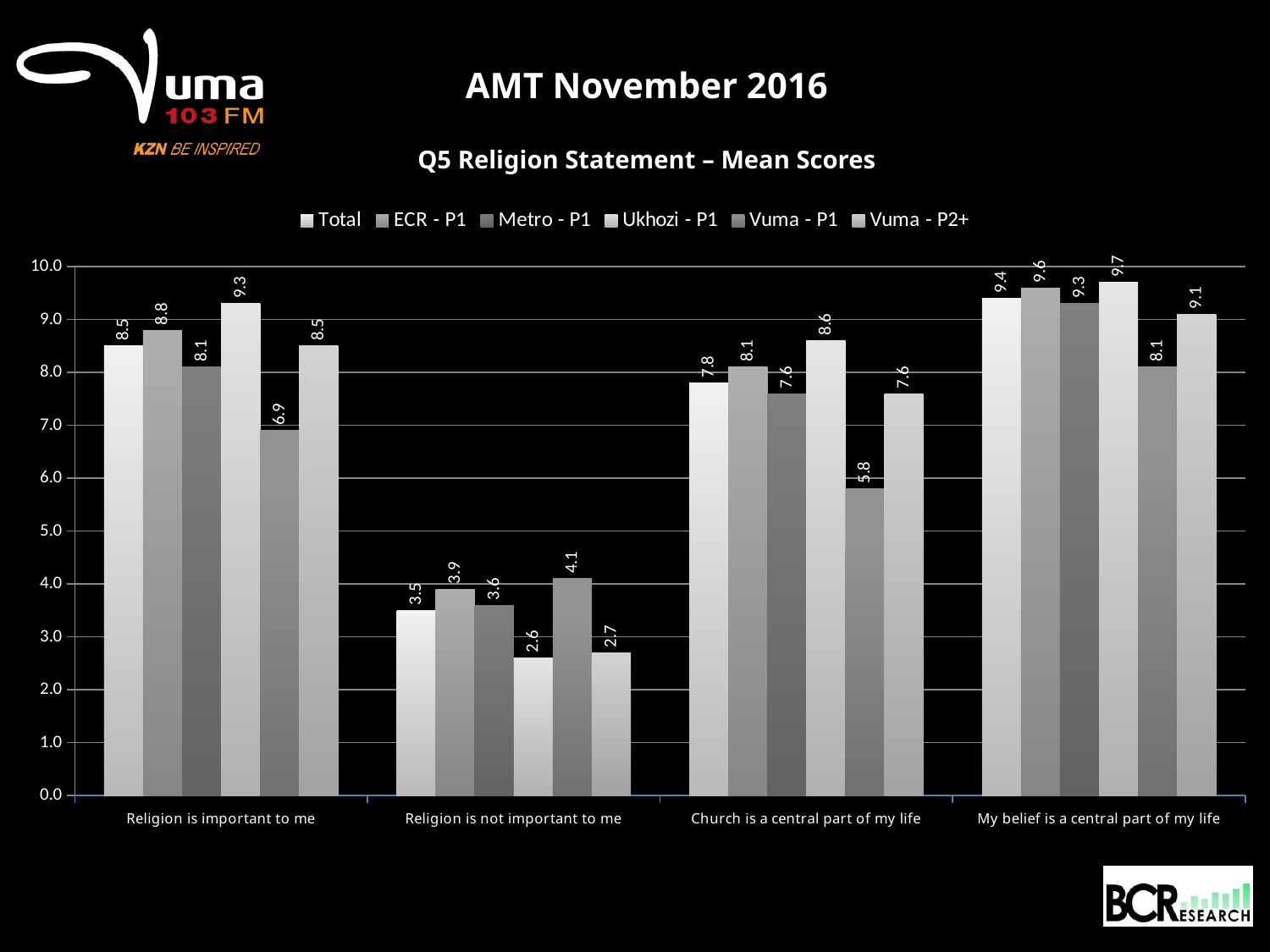
What is the Ukhozi - P1 mean score for "My belief is a central part of my life"? 9.7 Which series has the lowest mean score for "Religion is important to me"? Vuma - P1 What is the title of the chart? Q5 Religion Statement – Mean Scores How many religion statements (categories) are shown on the x axis? 4 What kind of chart is shown on the slide? Bar chart What is the Total mean score for "Religion is important to me"? 8.5 What is the difference between the Ukhozi - P1 and Vuma - P1 mean scores for "Church is a central part of my life"? 2.8 Is the Vuma - P2+ mean score for "Religion is not important to me" greater or less than 3.0? less What is the Vuma - P1 mean score for "Church is a central part of my life"? 5.8 Which series has the highest mean score for "Religion is not important to me"? Vuma - P1 How many series does the legend list? 6 Which is larger for "Religion is not important to me": the ECR - P1 score or the Metro - P1 score? ECR - P1